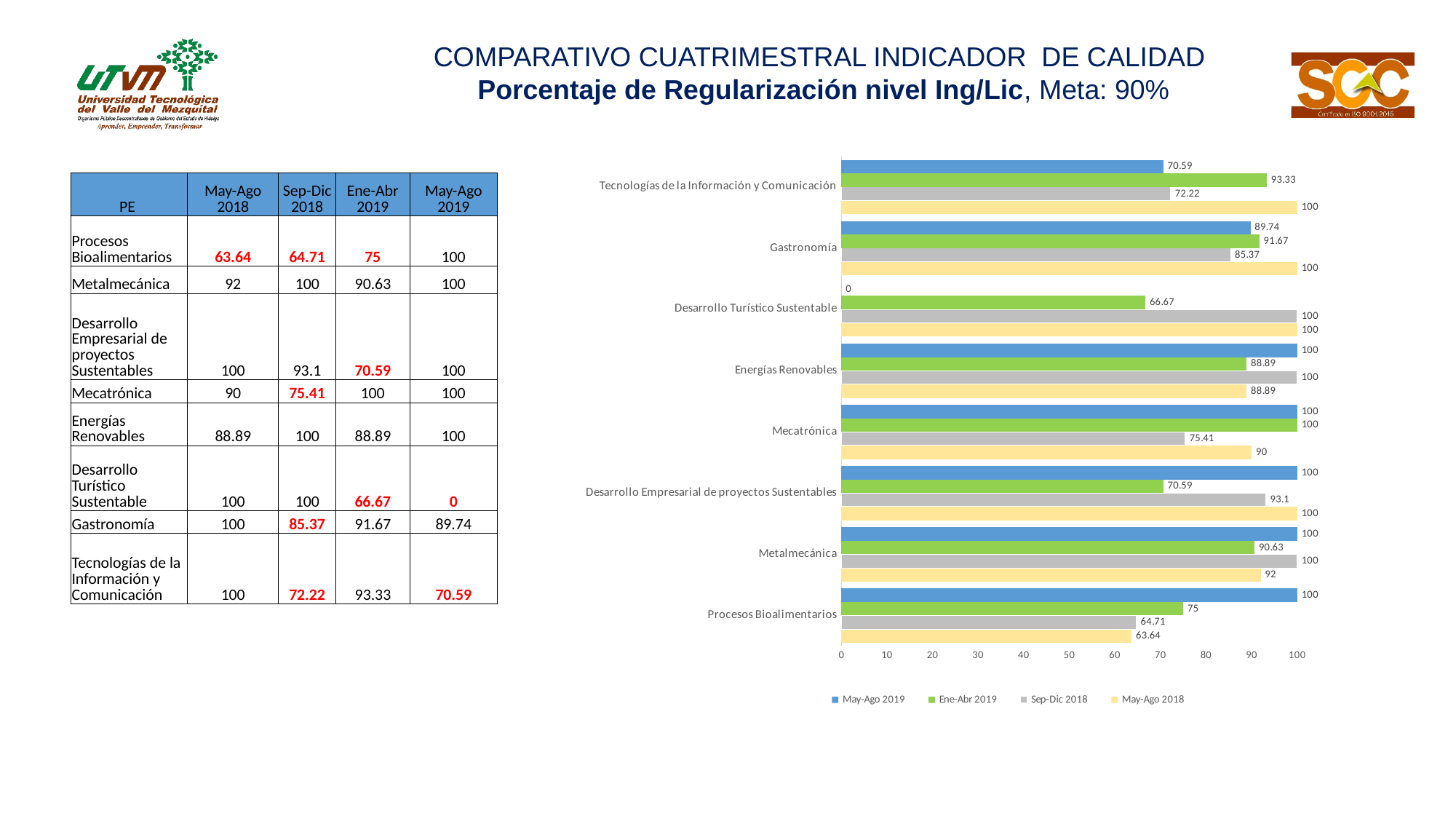
How many series does the chart legend list? 4 How many programs (categories) are plotted in the chart? 8 What type of chart is shown on the slide? bar chart Is the Ene-Abr 2019 value for Desarrollo Empresarial de proyectos Sustentables greater or less than 80? less Which program has the lowest May-Ago 2019 value in the chart? Desarrollo Turístico Sustentable For Mecatrónica, which is larger: the Sep-Dic 2018 value or the May-Ago 2018 value? May-Ago 2018 What is the difference between the Ene-Abr 2019 and Sep-Dic 2018 values for Procesos Bioalimentarios? 10.29 What is the May-Ago 2019 value for Tecnologías de la Información y Comunicación in the chart? 70.59 What is the Ene-Abr 2019 value for Desarrollo Turístico Sustentable in the chart? 66.67 Which program has the lowest May-Ago 2018 value in the chart? Procesos Bioalimentarios What is the Sep-Dic 2018 value for Gastronomía in the chart? 85.37 Which series is shown in green in the chart? Ene-Abr 2019